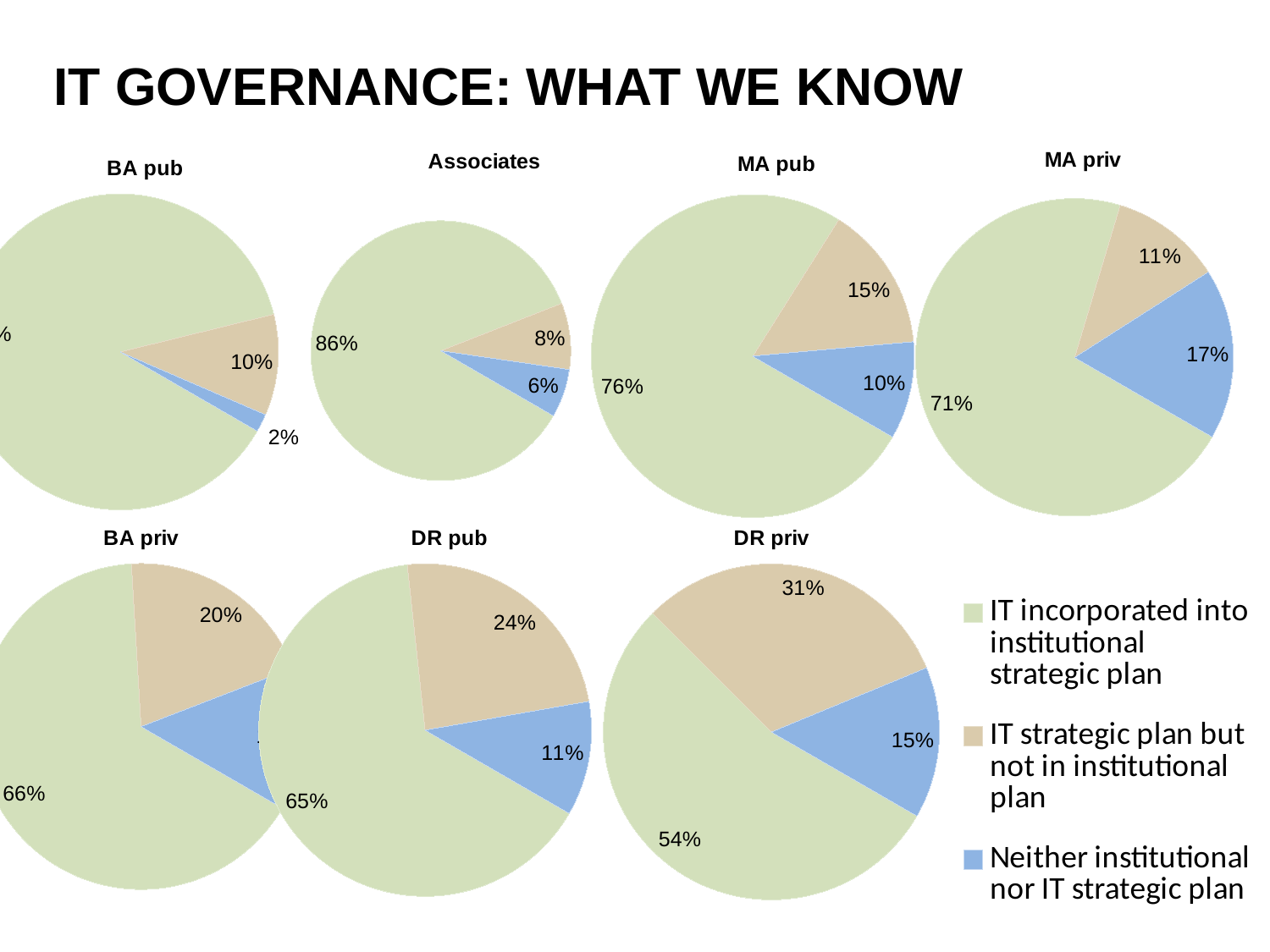
In the MA pub pie chart, what percentage is shown for the 'Neither institutional nor IT strategic plan' slice? 10% In the DR priv pie chart, what percentage is shown for the 'IT strategic plan but not in institutional plan' slice? 31% Which is larger: the 'IT strategic plan but not in institutional plan' share in DR pub or in DR priv? DR priv How many pie charts are shown on the slide? 7 How many categories does the legend list? 3 In the MA priv pie chart, what percentage is shown for the 'Neither institutional nor IT strategic plan' slice? 17% In the MA pub pie chart, what is the difference between the 'IT incorporated into institutional strategic plan' share and the 'IT strategic plan but not in institutional plan' share? 61% What colour represents 'Neither institutional nor IT strategic plan' in the charts? Blue In the Associates pie chart, what share is labelled for the 'IT incorporated into institutional strategic plan' slice? 86% In the BA pub pie chart, which category has the smallest share? Neither institutional nor IT strategic plan In the DR pub pie chart, which category has the largest share? IT incorporated into institutional strategic plan What type of chart is used for the BA priv data? Pie chart